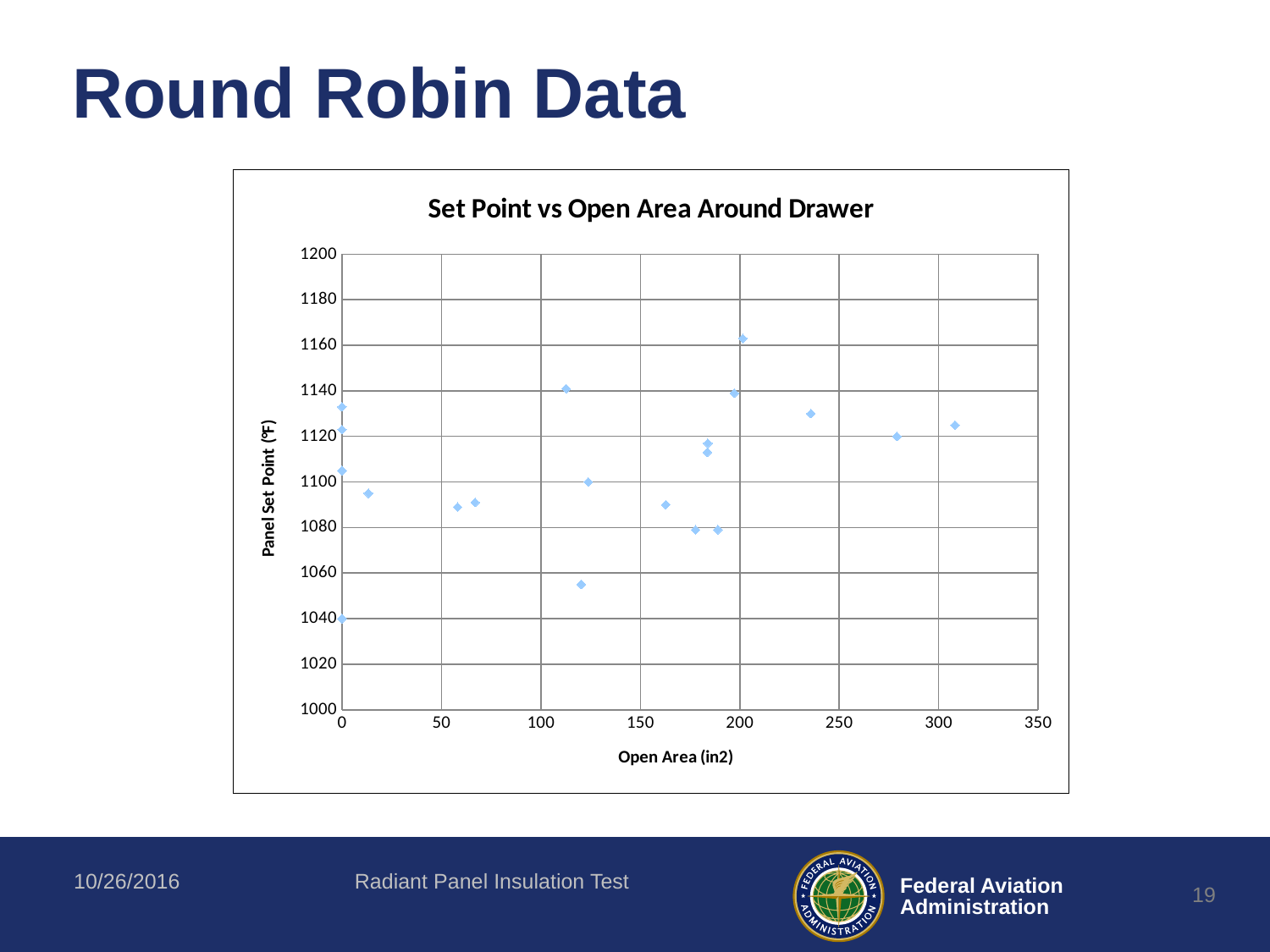
Is the panel set point for the lowest point near an open area of 120 in2 greater or less than 1080? less Is the panel set point for the point with the largest open area (around 300 in2) greater or less than 1100? greater Is the highest plotted panel set point greater or less than 1140? greater Which has the higher panel set point: the highest point near an open area of 200 in2 or the point near an open area of 280 in2? The point near 200 in2 What is the title of the chart? Set Point vs Open Area Around Drawer What kind of chart is shown on the slide? Scatter chart What is the label of the vertical axis? Panel Set Point (°F) What is the maximum value shown on the vertical axis? 1200 Which has the lower panel set point: the lowest point at an open area of 0 in2 or the point near an open area of 160 in2? The point at 0 in2